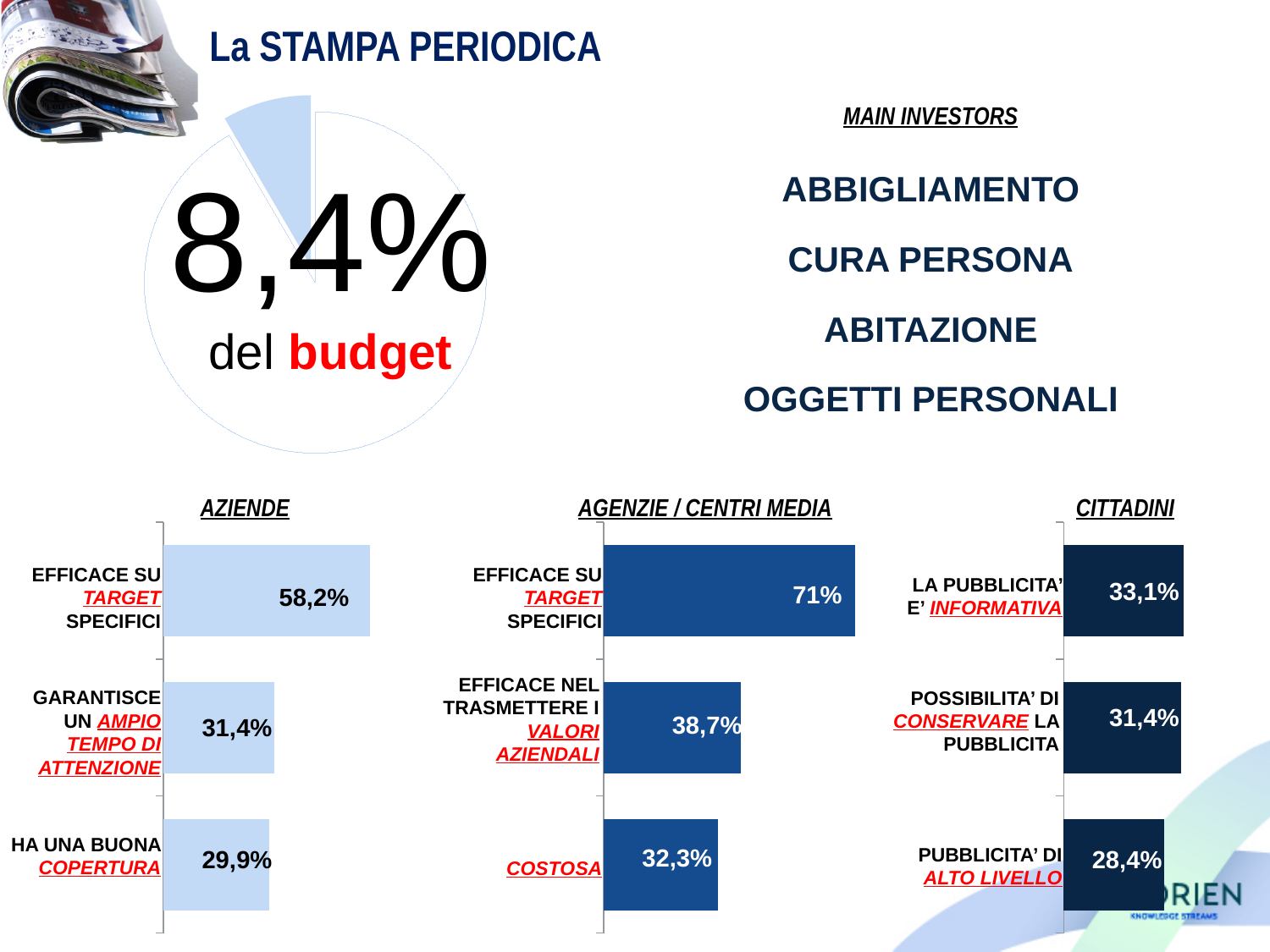
What kind of chart is the one at the top left showing 8,4% del budget? Pie chart In the AGENZIE / CENTRI MEDIA chart, which category has the highest value? EFFICACE SU TARGET SPECIFICI In the AGENZIE / CENTRI MEDIA chart, which is larger: 'EFFICACE NEL TRASMETTERE I VALORI AZIENDALI' or 'COSTOSA'? EFFICACE NEL TRASMETTERE I VALORI AZIENDALI What kind of chart is the AZIENDE chart? Bar chart In the CITTADINI chart, what is the value for 'POSSIBILITA' DI CONSERVARE LA PUBBLICITA'? 31,4% In the AGENZIE / CENTRI MEDIA chart, what is the difference between 'EFFICACE SU TARGET SPECIFICI' and 'EFFICACE NEL TRASMETTERE I VALORI AZIENDALI'? 32,3% What share of the budget does the pie chart at the top left show for the periodical press? 8,4% In the AGENZIE / CENTRI MEDIA chart, what is the value for 'COSTOSA'? 32,3% In the AZIENDE chart, what is the difference between 'EFFICACE SU TARGET SPECIFICI' and 'HA UNA BUONA COPERTURA'? 28,3% How many categories does the CITTADINI chart show? 3 In the CITTADINI chart, which category has the lowest value? PUBBLICITA' DI ALTO LIVELLO In the AZIENDE chart, what is the value for 'EFFICACE SU TARGET SPECIFICI'? 58,2%